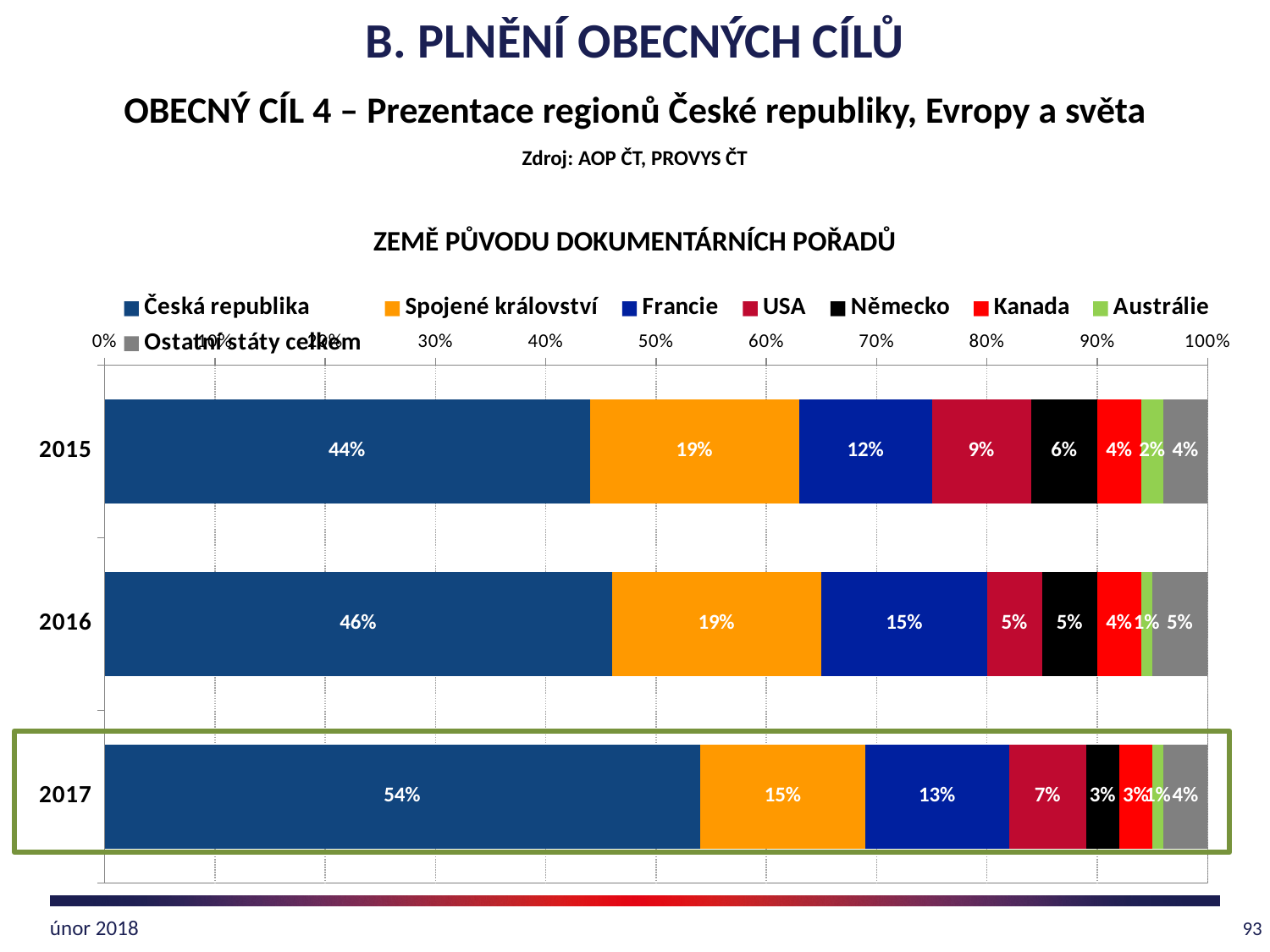
What is the title of the chart? ZEMĚ PŮVODU DOKUMENTÁRNÍCH POŘADŮ Which is larger in 2016: the share of USA or the share of Francie? Francie In which year is the share of Česká republika the highest? 2017 Does the share of Česká republika rise or fall from 2015 to 2017? Rise How many series does the legend list? 8 What is the difference between the share of Česká republika in 2017 and in 2015? 10 percentage points How many years (categories) are plotted on the chart? 3 What is the share of USA in 2015? 9% In which year is the share of Spojené království the lowest? 2017 What is the share of Francie in 2016? 15% What type of chart is shown on the slide? Stacked bar chart What is the share of Česká republika in 2017? 54%